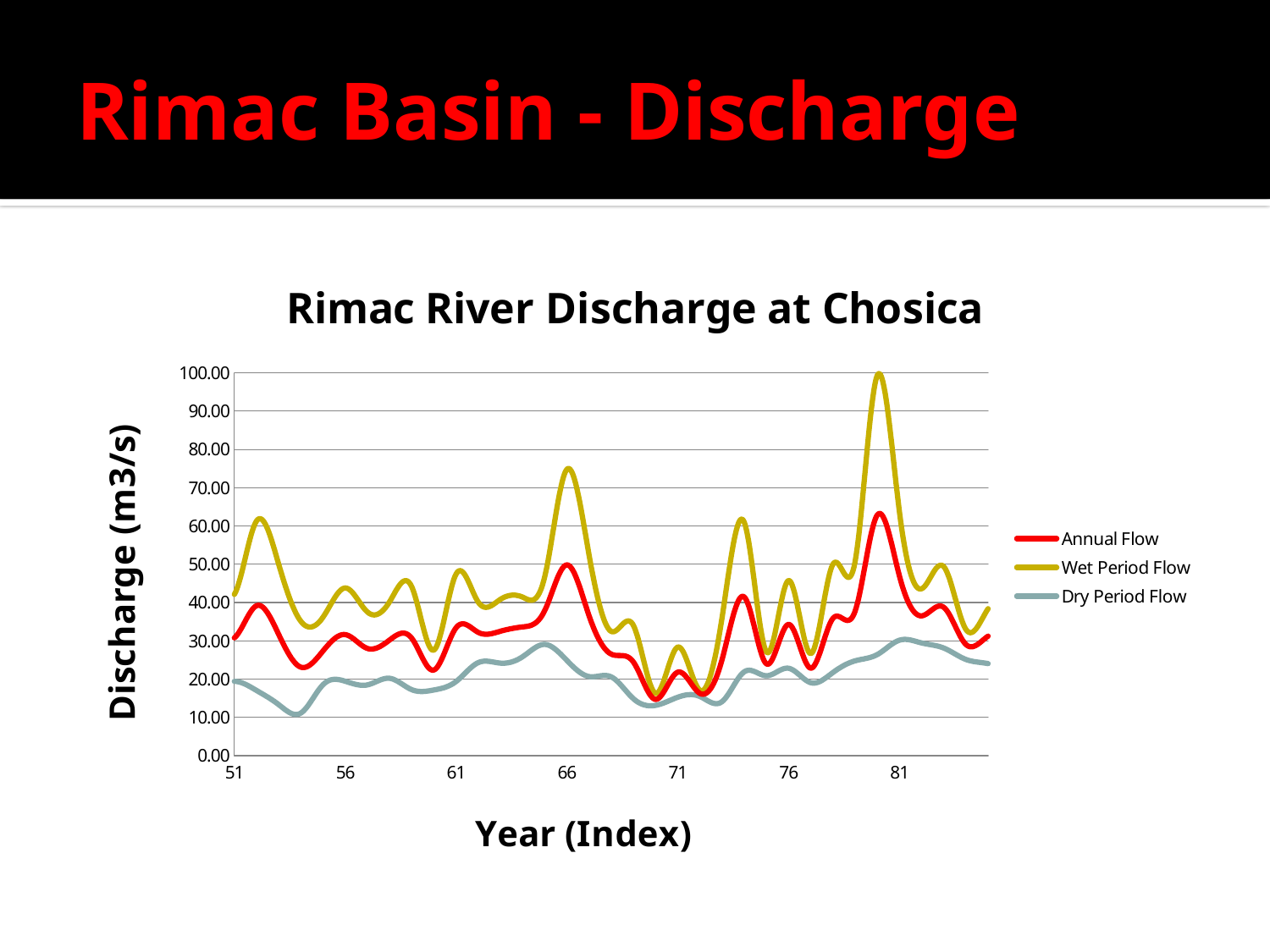
At year index 66, which is larger: Wet Period Flow or Dry Period Flow? Wet Period Flow Is the value of Wet Period Flow at year index 71 greater or less than 40.00? less What kind of chart is shown on the slide? line chart Is the highest peak of Wet Period Flow greater or less than 90.00? greater What is the label of the y axis? Discharge (m3/s) Which series reaches the highest value on the chart? Wet Period Flow Is the value of Annual Flow at year index 66 greater or less than 40.00? greater How many series does the legend list? 3 What is the first year index labelled on the x axis? 51 What is the title of the chart? Rimac River Discharge at Chosica Which series stays lowest across the chart? Dry Period Flow